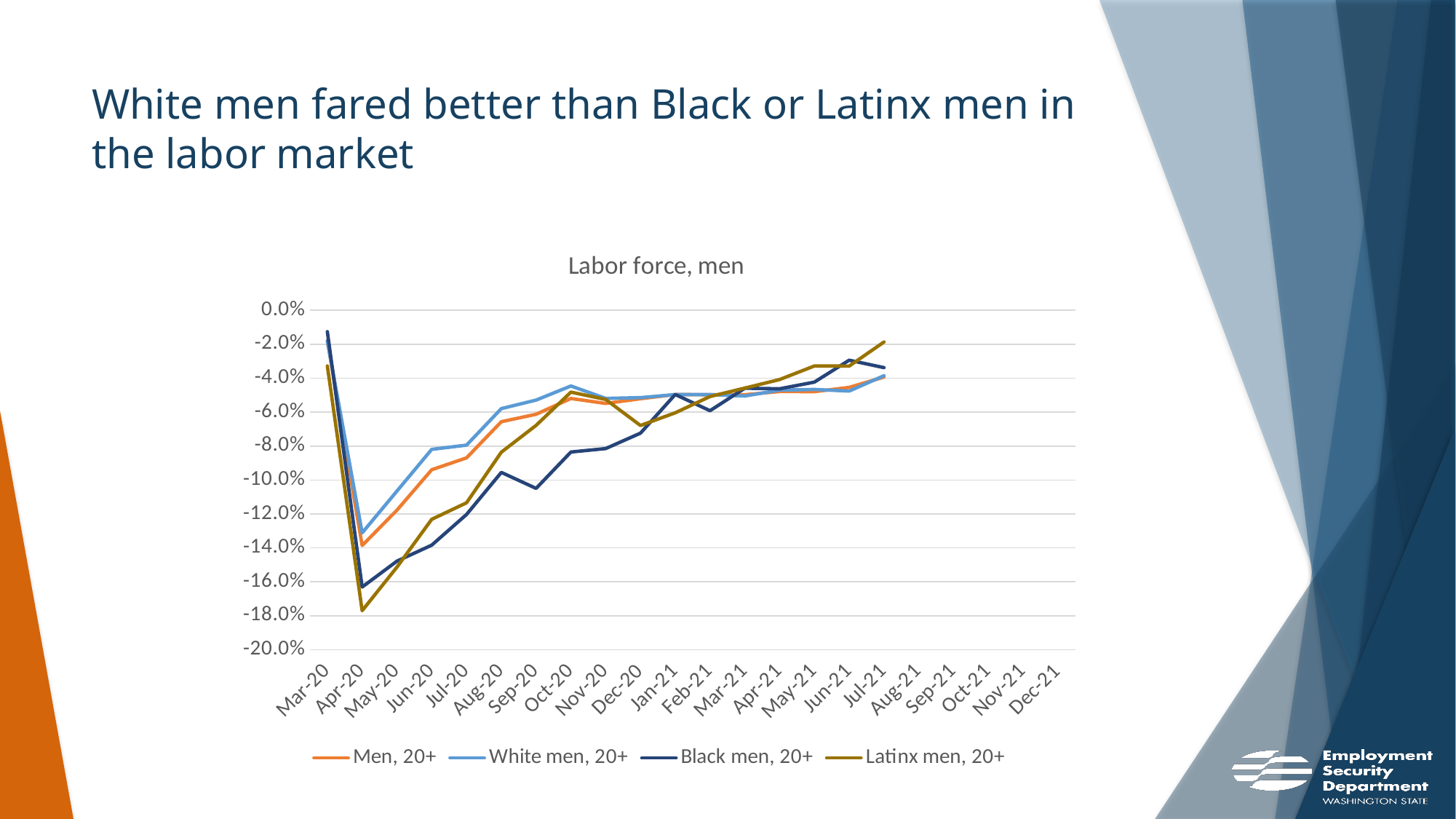
Which series has the lowest value in Apr-20? Latinx men, 20+ What is the title of the chart? Labor force, men From Apr-20 to Jul-21, does the Latinx men, 20+ line generally rise or fall? rise Is the value for Latinx men, 20+ in Jul-21 greater or less than -4.0%? greater Is the value for Black men, 20+ in Sep-20 greater or less than -10.0%? less How many month labels are shown on the x axis? 22 How many series does the legend list? 4 Which series has the highest value in Apr-20? White men, 20+ Is the value for Latinx men, 20+ in Apr-20 greater or less than -16.0%? less In Jun-20, which is higher: White men, 20+ or Black men, 20+? White men, 20+ What kind of chart is shown on the slide? line chart